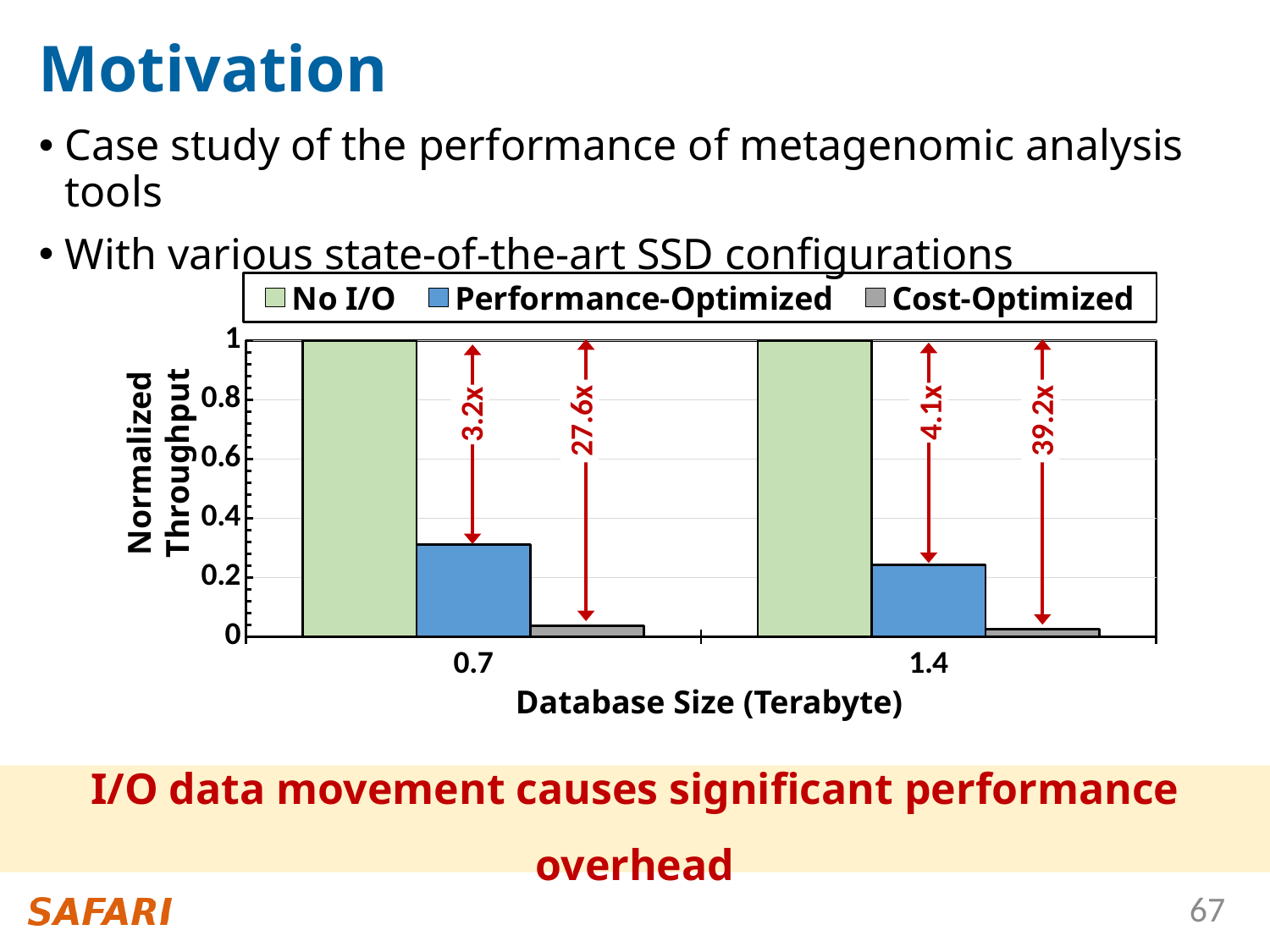
Is the Performance-Optimized value at database size 1.4 greater or less than 0.2? greater At database size 1.4, which is larger: the Performance-Optimized bar or the Cost-Optimized bar? Performance-Optimized How many database size categories are shown on the x axis? 2 Does the Performance-Optimized normalized throughput rise or fall from database size 0.7 to 1.4? fall Which series has the lowest normalized throughput at database size 1.4? Cost-Optimized How many series does the chart's legend list? 3 Is the Performance-Optimized value at database size 0.7 greater or less than 0.4? less What slowdown factor is annotated for the Performance-Optimized bar at database size 0.7? 3.2x What kind of chart is shown on the slide? bar chart What slowdown factor is annotated for the Cost-Optimized bar at database size 1.4? 39.2x What is the title of the x axis? Database Size (Terabyte) What is the normalized throughput of the No I/O bar at database size 0.7? 1